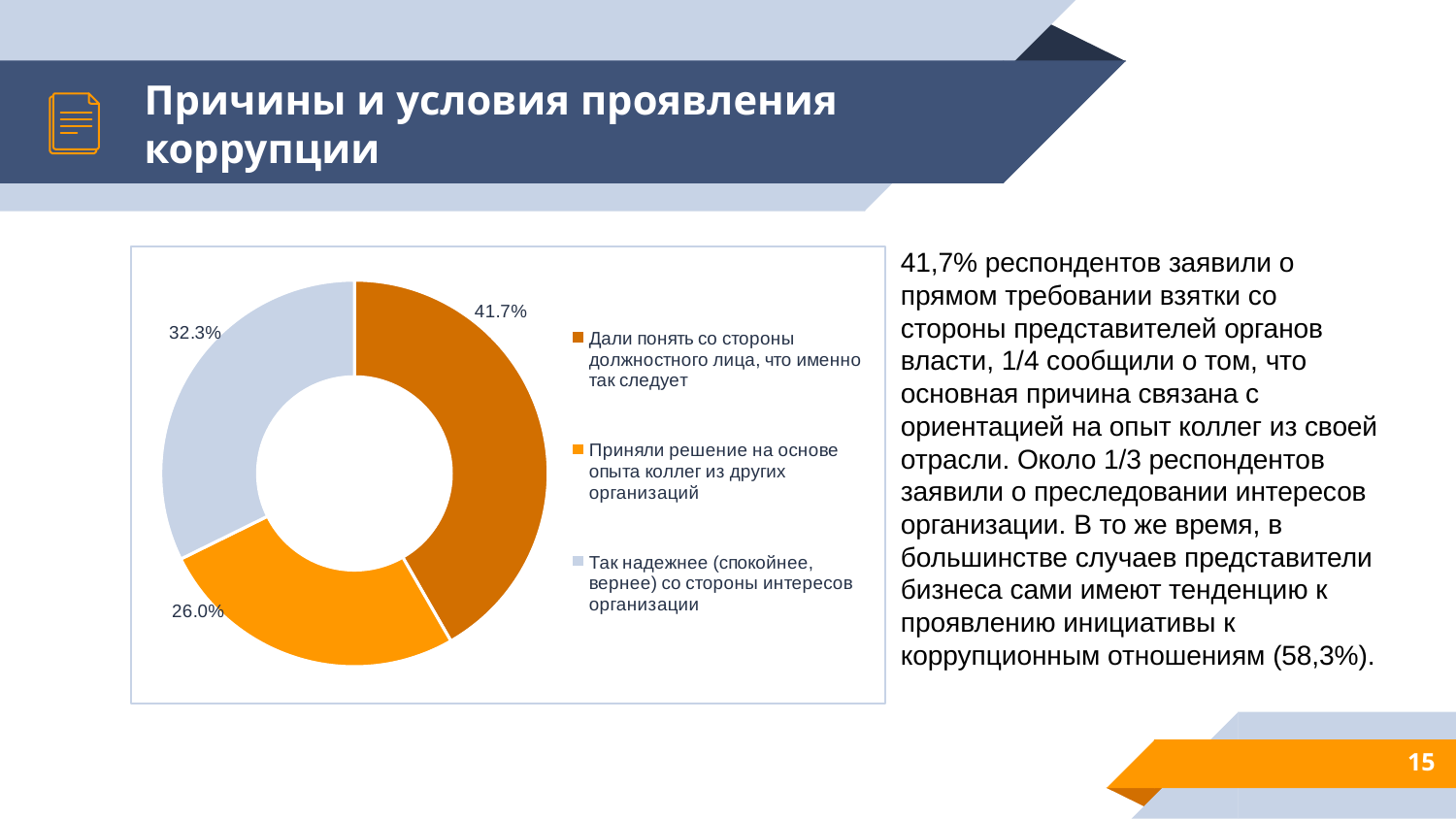
Which is larger: the share for "Так надежнее (спокойнее, вернее) со стороны интересов организации" or the share for "Приняли решение на основе опыта коллег из других организаций"? Так надежнее (спокойнее, вернее) со стороны интересов организации What colour is the slice labelled 32.3%? Light blue-grey Which category has the smallest share of the chart? Приняли решение на основе опыта коллег из других организаций What percentage is shown for the slice "Приняли решение на основе опыта коллег из других организаций"? 26.0% How many entries does the chart legend list? 3 What type of chart is shown on the slide? Doughnut (pie) chart What percentage is shown for the slice "Дали понять со стороны должностного лица, что именно так следует"? 41.7% How many slices does the chart have? 3 What percentage is shown for the slice "Так надежнее (спокойнее, вернее) со стороны интересов организации"? 32.3% What is the difference in percentage points between the largest slice (41.7%) and the smallest slice (26.0%)? 15.7 What is the difference in percentage points between the slices labelled 32.3% and 26.0%? 6.3 Which category has the largest share of the chart? Дали понять со стороны должностного лица, что именно так следует